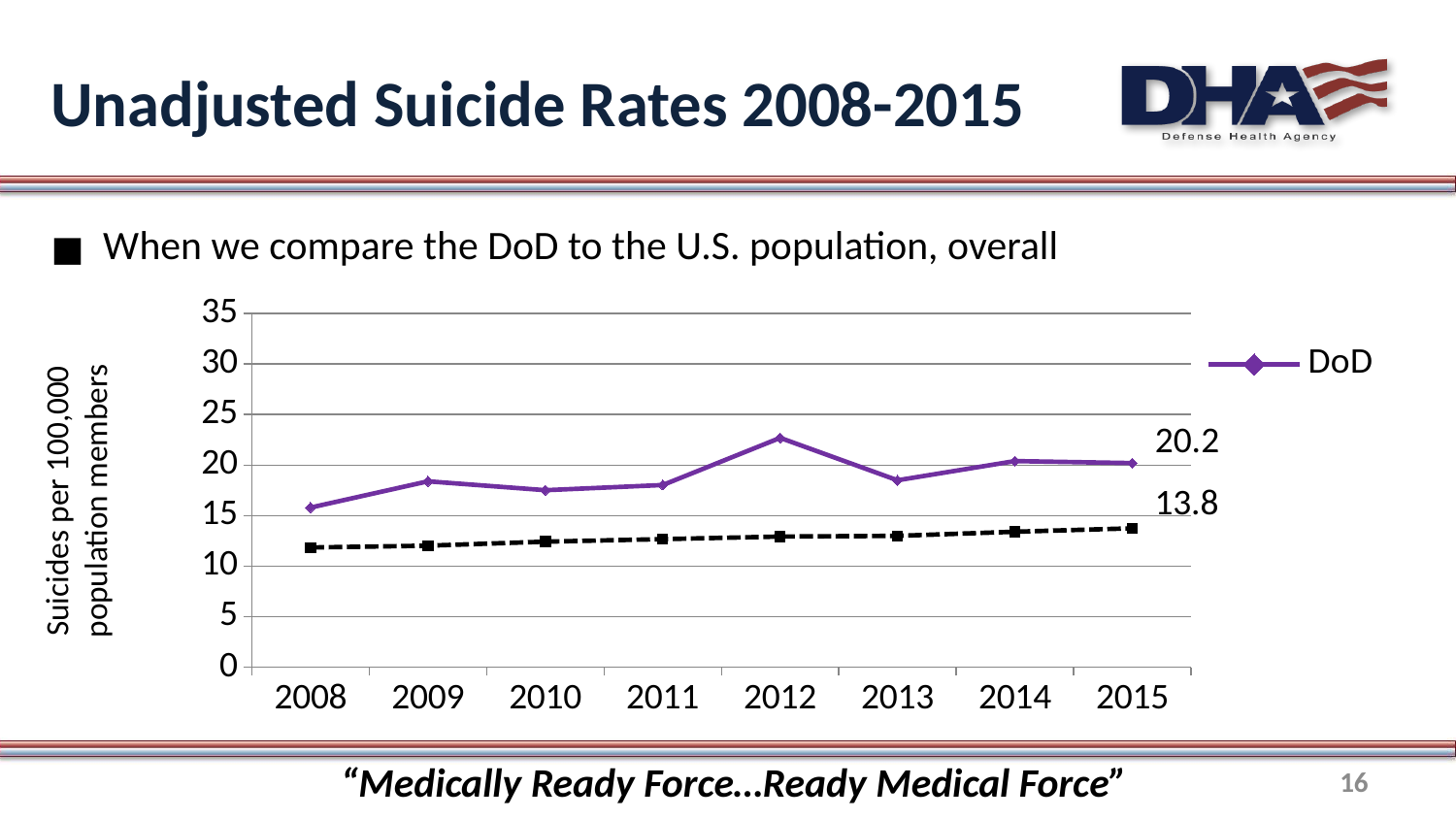
How many years are shown on the x axis? 8 What kind of chart is shown on the slide? line chart Does the black dashed line rise or fall from 2008 to 2015? rises Is the DoD value for 2012 greater or less than 20? greater What is the label on the y axis? Suicides per 100,000 population members What is the difference between the DoD value and the black dashed line value in 2015? 6.4 What is the DoD value in 2015? 20.2 In which year is the DoD line at its lowest? 2008 What is the value of the black dashed line in 2015? 13.8 In 2015, which is larger: the DoD value or the black dashed line value? DoD Is the value of the black dashed line for 2008 greater or less than 15? less In which year is the DoD line at its highest? 2012